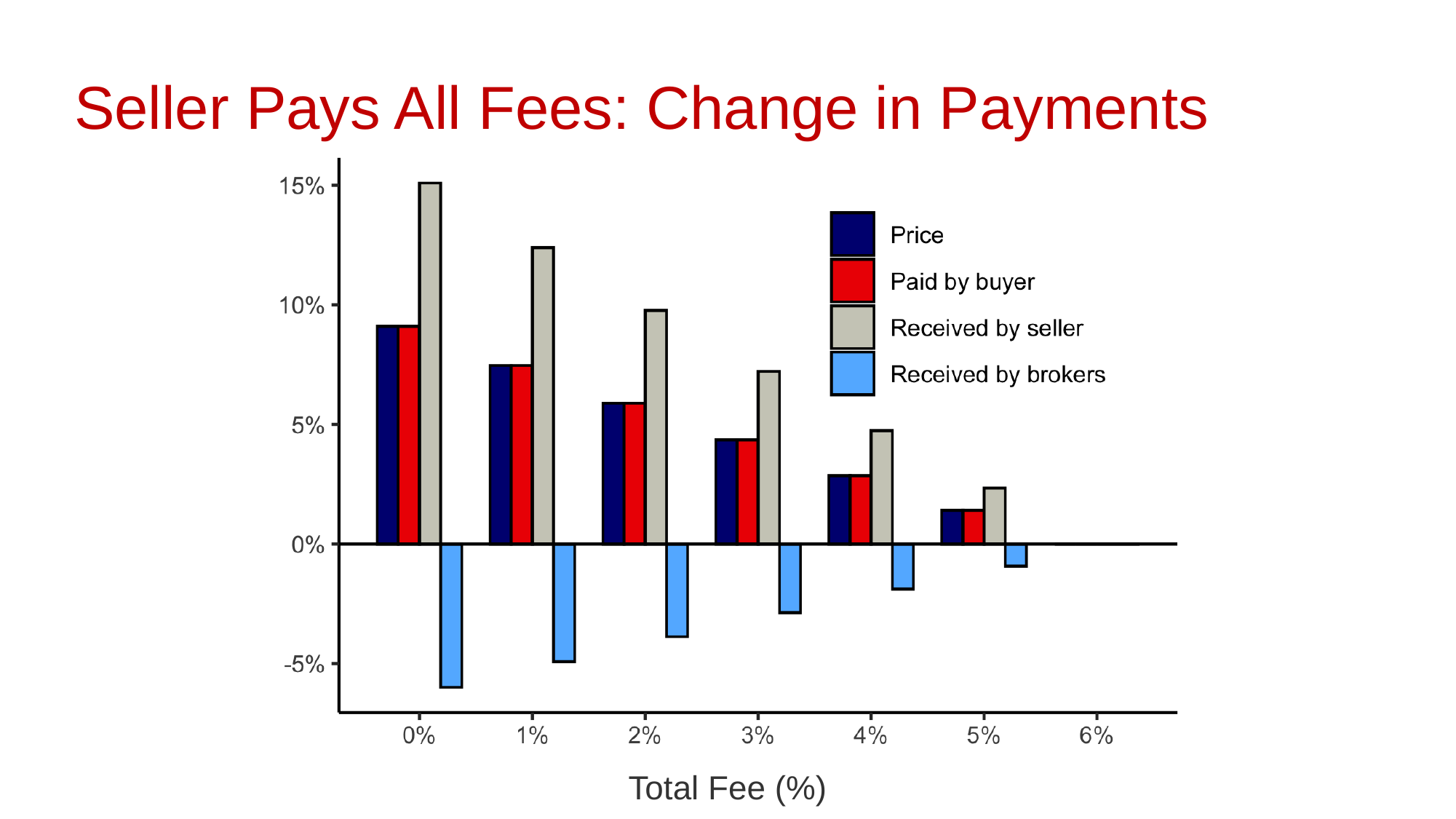
At a total fee of 3%, which is larger: Received by seller or Price? Received by seller What are the four series named in the legend? Price, Paid by buyer, Received by seller, Received by brokers Is the value for Received by seller at a total fee of 0% greater or less than 10%? greater At which total fee is the Received by seller value highest? 0% Is the value for Received by brokers at a total fee of 5% greater or less than -5%? greater How many series does the legend list? 4 Is the value for Received by brokers at a total fee of 0% greater or less than -5%? less Do the Received by seller values rise or fall as the total fee increases along the x axis? fall Which series has the lowest value at a total fee of 0%? Received by brokers What is the title of the x axis? Total Fee (%) What kind of chart is shown on the slide? bar chart